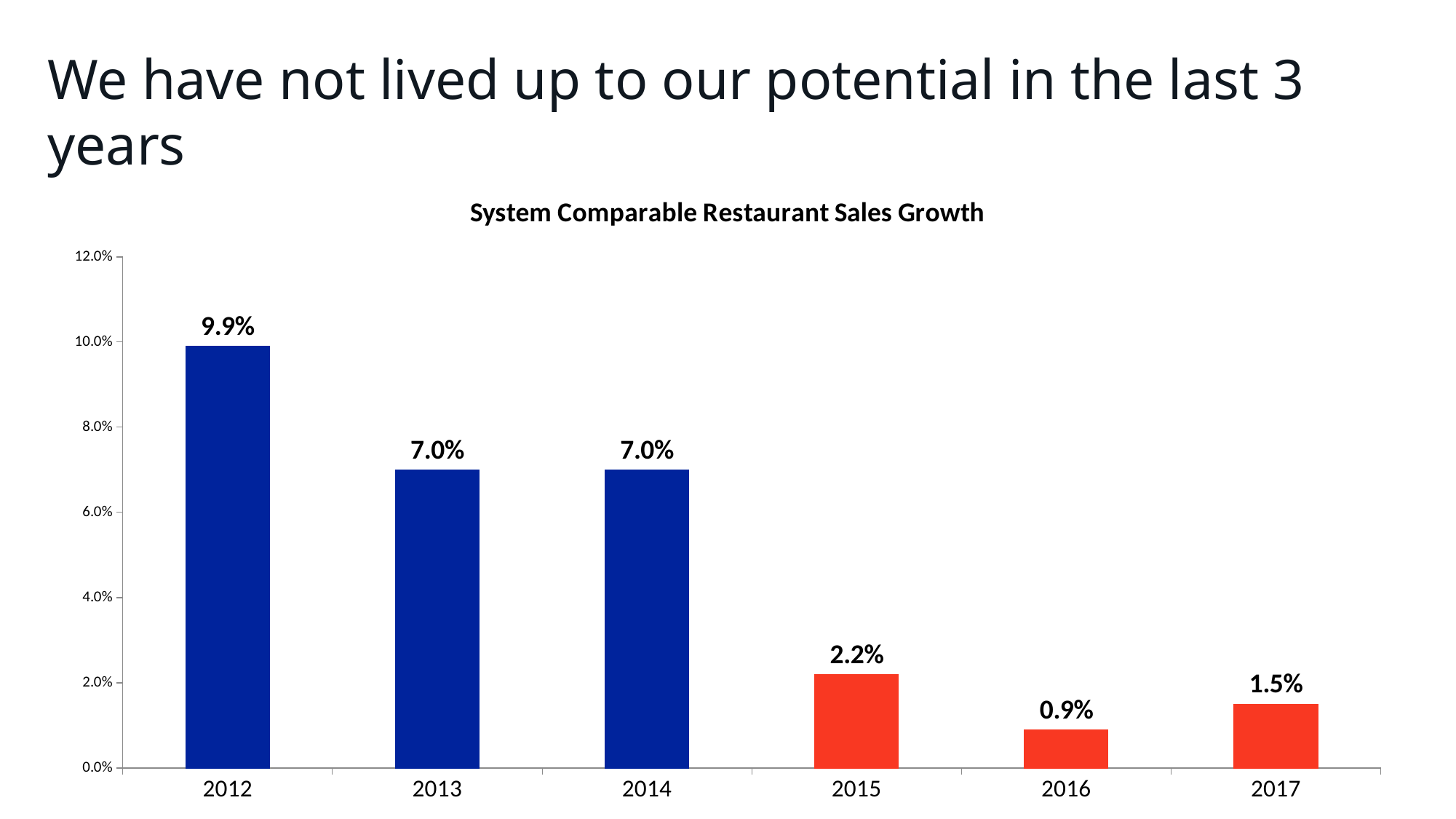
What is the title of the chart? System Comparable Restaurant Sales Growth What is the System Comparable Restaurant Sales Growth for 2017? 1.5% What is the System Comparable Restaurant Sales Growth for 2012? 9.9% What is the System Comparable Restaurant Sales Growth for 2015? 2.2% Which year has the lowest System Comparable Restaurant Sales Growth? 2016 Which year has higher sales growth, 2015 or 2017? 2015 Which year has the highest System Comparable Restaurant Sales Growth? 2012 How many years are shown on the chart? 6 What kind of chart is shown on the slide? Bar chart What is the difference between the sales growth in 2015 and 2016? 1.3% What is the difference between the sales growth in 2012 and 2013? 2.9% Is the value for 2014 greater or less than 6.0%? greater